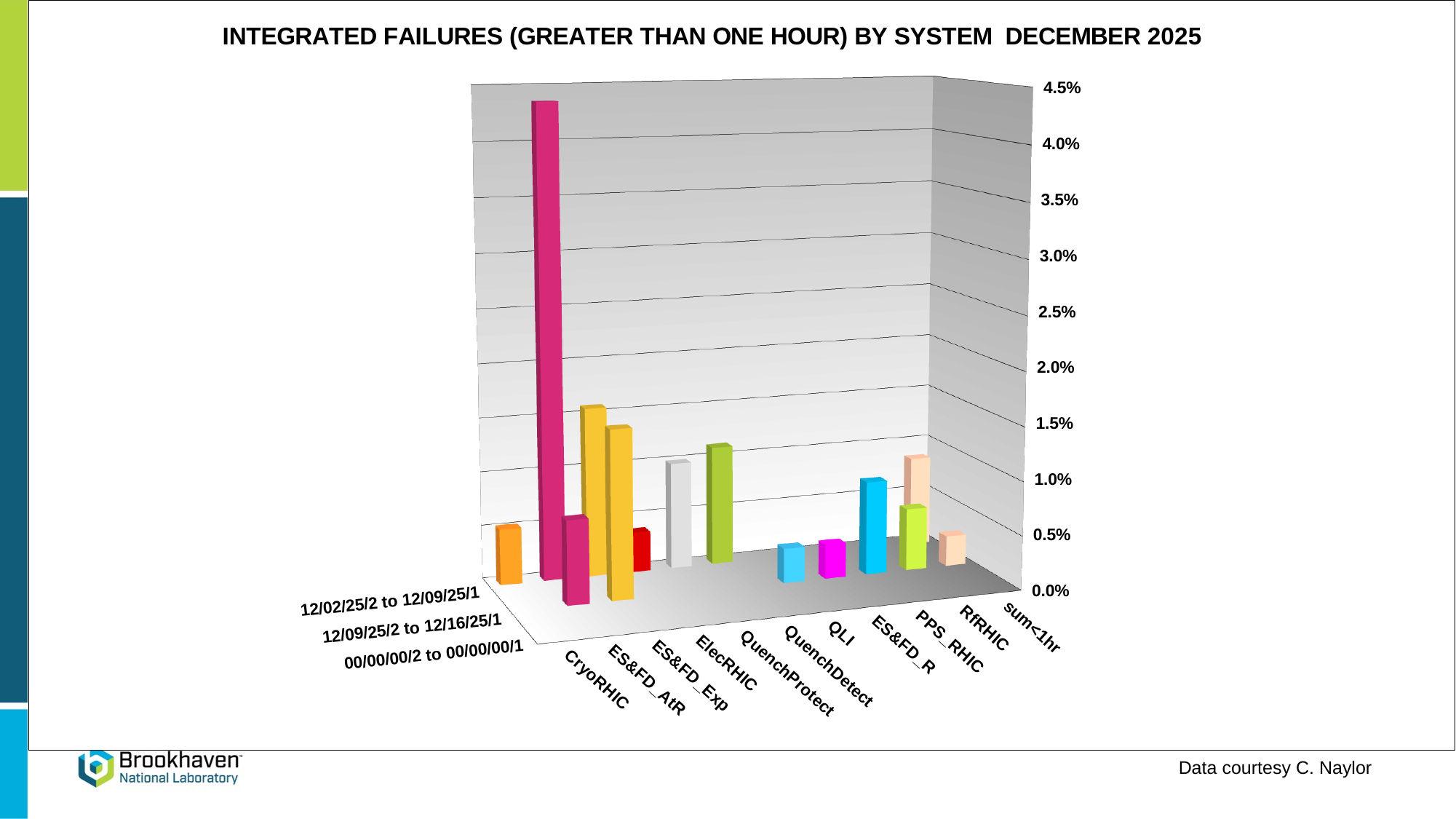
Is the value of the tallest bar on the chart greater or less than 4.0%? greater Which system has the tallest bar on the chart? ES&FD_AtR What is the highest value shown on the vertical axis? 4.5% How many system categories are shown along the category axis? 11 Is the tallest bar for ES&FD_AtR greater or less than 3.0%? greater Which is larger, the tallest bar for ES&FD_AtR or the tallest bar for CryoRHIC? ES&FD_AtR What is the title of the chart? INTEGRATED FAILURES (GREATER THAN ONE HOUR) BY SYSTEM DECEMBER 2025 Which is larger, the tallest bar for ES&FD_AtR or the tallest bar for QLI? ES&FD_AtR What kind of chart is shown on the slide? bar chart How many date-range series are plotted on the chart? 3